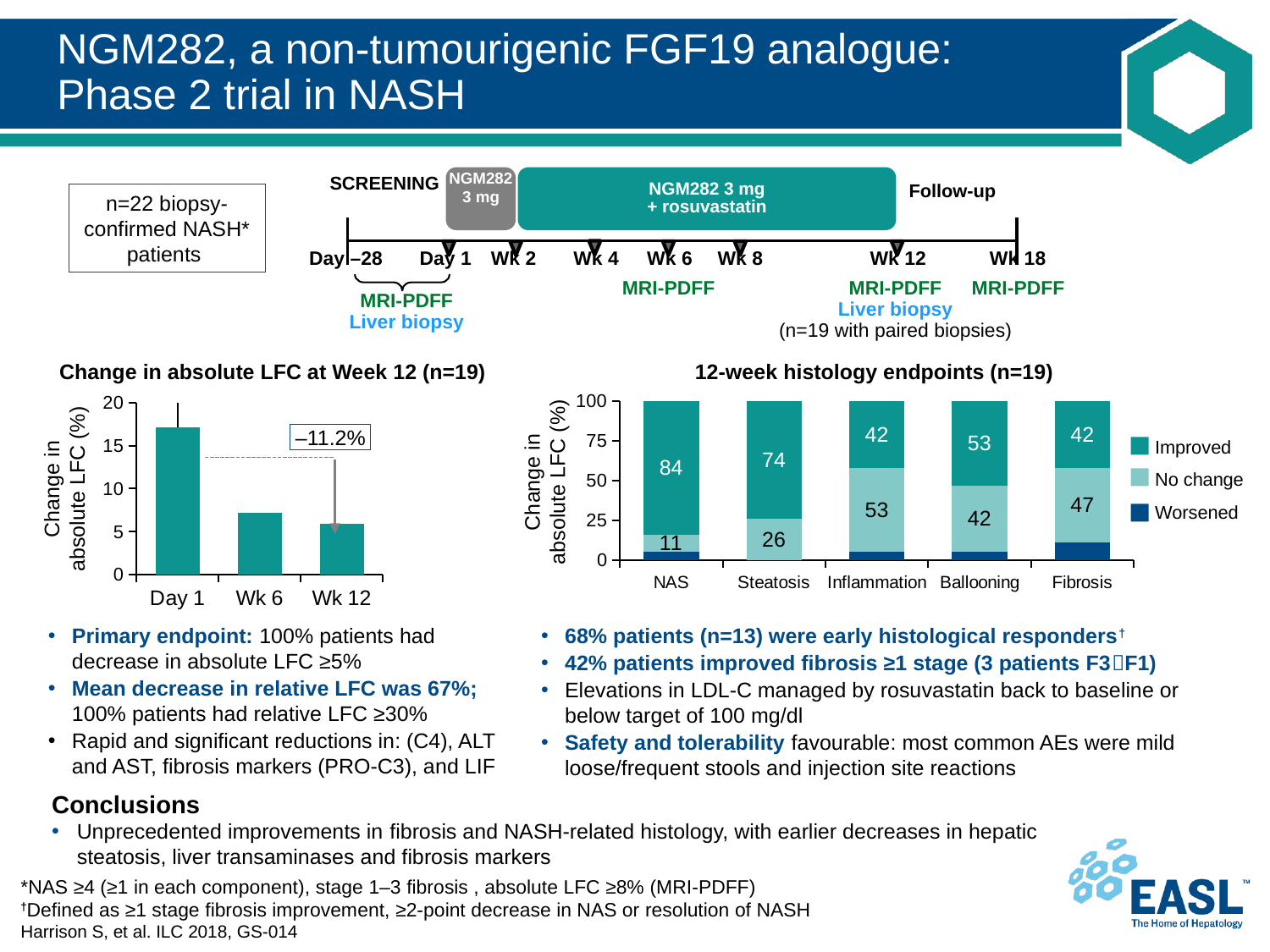
In the '12-week histology endpoints (n=19)' chart, what is the 'Improved' value for Fibrosis? 42 In the '12-week histology endpoints (n=19)' chart, which category has the highest 'Improved' value? NAS In the '12-week histology endpoints (n=19)' chart, what is the 'No change' value for Inflammation? 53 In the '12-week histology endpoints (n=19)' chart, which category has the lowest 'No change' value? NAS What kind of chart is the 'Change in absolute LFC at Week 12 (n=19)' chart? Bar chart In the '12-week histology endpoints (n=19)' chart, is the 'Improved' value larger for Ballooning or for Inflammation? Ballooning In the '12-week histology endpoints (n=19)' chart, what is the difference between the 'Improved' values for NAS and Steatosis? 10 How many categories are shown on the x axis of the '12-week histology endpoints (n=19)' chart? 5 In the 'Change in absolute LFC at Week 12 (n=19)' chart, is the value for Day 1 greater or less than 15? greater How many series does the legend of the '12-week histology endpoints (n=19)' chart list? 3 In the 'Change in absolute LFC at Week 12 (n=19)' chart, do the values rise or fall from Day 1 to Wk 12? Fall In the '12-week histology endpoints (n=19)' chart, what percentage of patients improved in NAS? 84